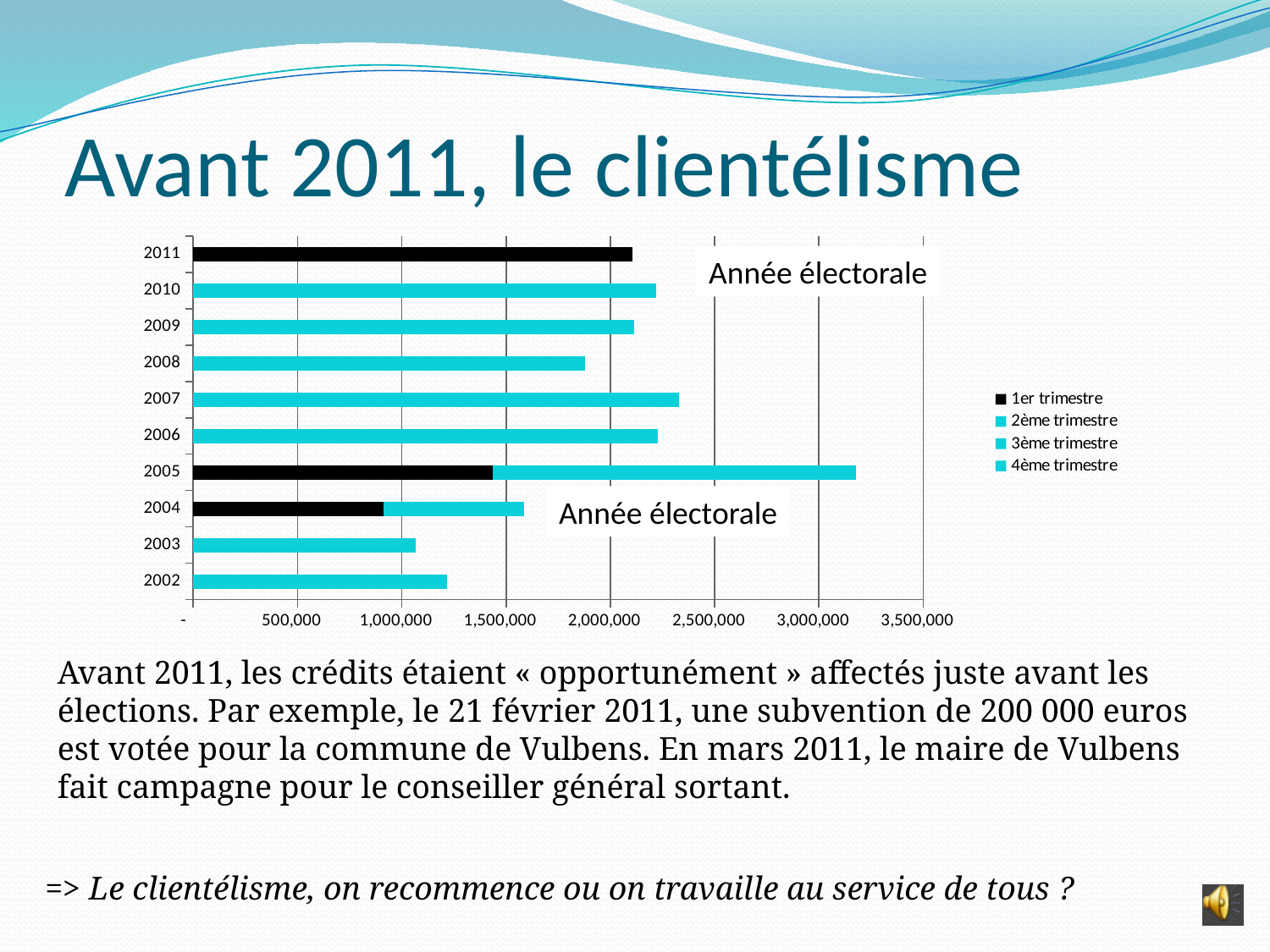
Which year has the shortest total bar on the chart? 2003 Is the total value for 2005 greater or less than 3,000,000? greater How many years (categories) are shown on the chart? 10 Which year has the larger total bar, 2005 or 2004? 2005 Which year has the longest total bar on the chart? 2005 Which year has the larger total bar, 2007 or 2008? 2007 How many series does the chart legend list? 4 Is the total value for 2008 greater or less than 2,000,000? less Is the total value for 2007 greater or less than 2,000,000? greater What kind of chart is shown on the slide? bar chart What is the first entry listed in the chart legend? 1er trimestre